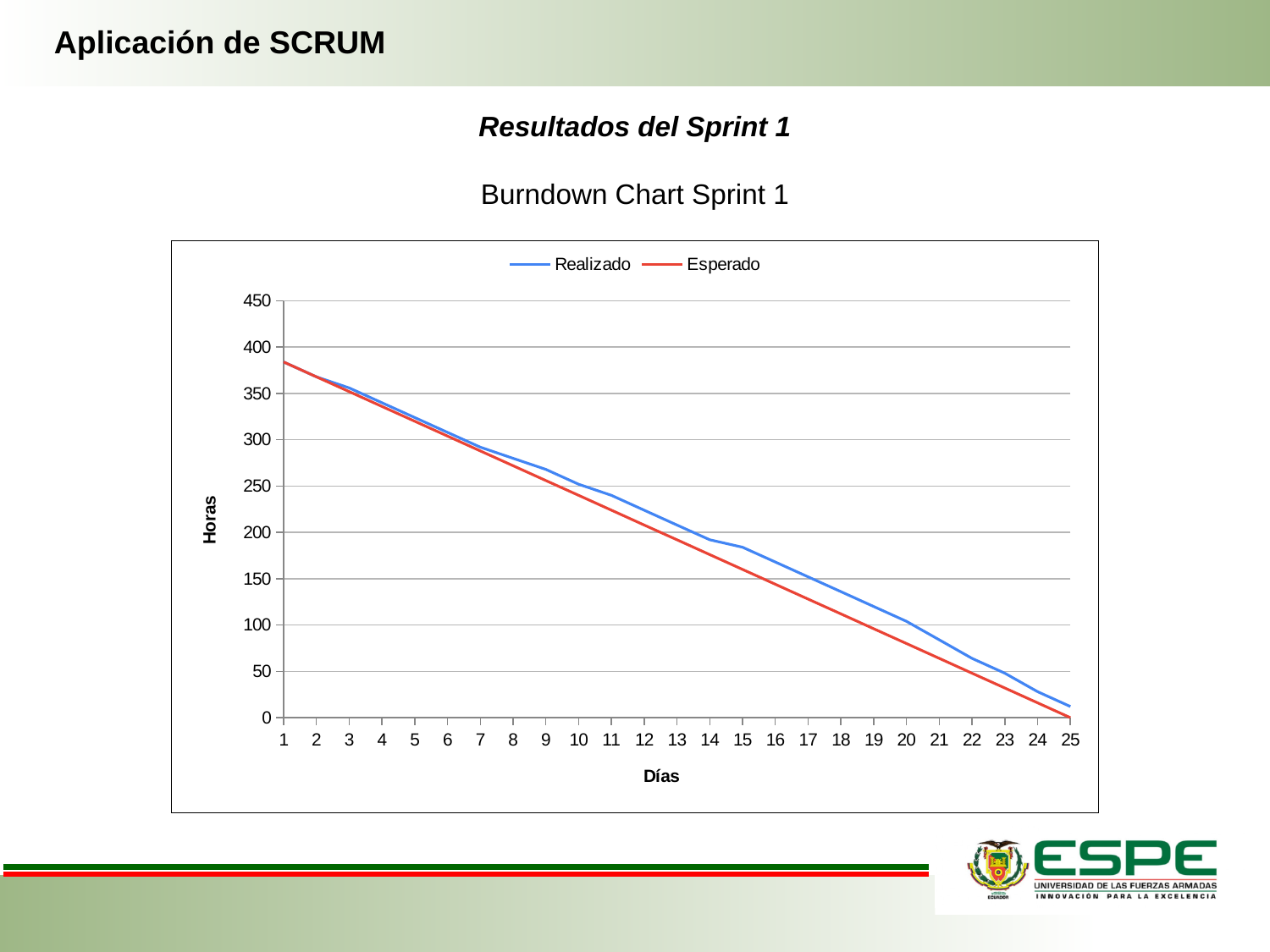
How many series does the legend list? 2 What are the names of the two series in the legend? Realizado and Esperado What is the value of the Esperado series on day 25? 0 On day 20, which series has the higher value, Realizado or Esperado? Realizado Is the value of Esperado on day 20 greater or less than 100? less What kind of chart is shown on the slide? line chart Do the values of the Realizado series rise or fall as the days increase? fall Is the value of Esperado on day 13 greater or less than 250? less Is the value of Realizado on day 1 greater or less than 350? greater What is the label of the y axis? Horas How many days are shown along the x axis? 25